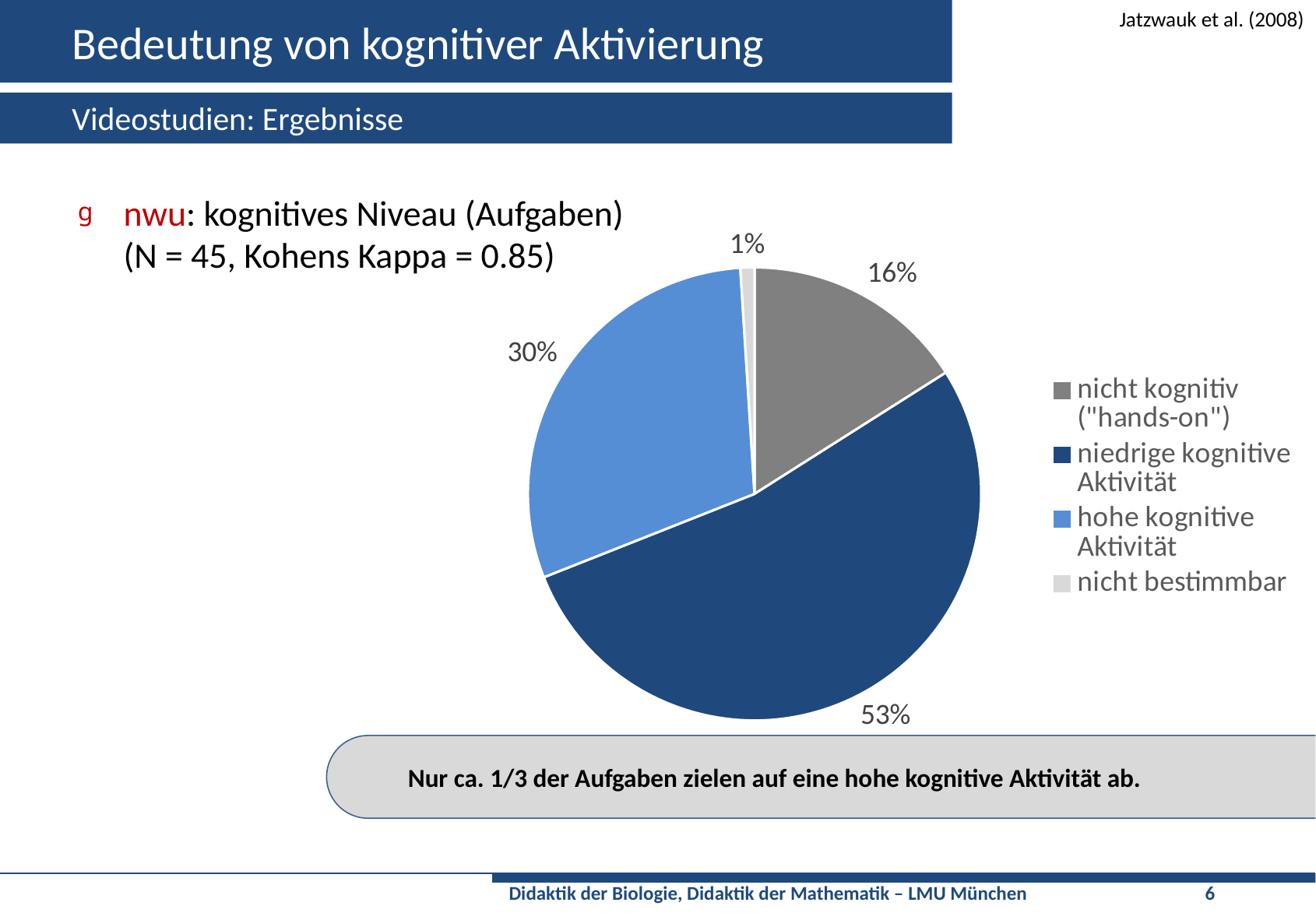
What kind of chart is shown on the slide? pie chart What colour is the slice for "hohe kognitive Aktivität"? light blue How many slices does the pie chart have? 4 Which is larger: the slice for "hohe kognitive Aktivität" or the slice for "nicht kognitiv ("hands-on")"? hohe kognitive Aktivität Which category has the largest slice of the pie? niedrige kognitive Aktivität What is the difference in percentage points between "niedrige kognitive Aktivität" and "hohe kognitive Aktivität"? 23 percentage points What share of the pie is labelled "nicht bestimmbar"? 1% How many entries does the legend list? 4 Which category has the smallest slice of the pie? nicht bestimmbar What share of the pie is labelled "niedrige kognitive Aktivität"? 53% What share of the pie is labelled "nicht kognitiv ("hands-on")"? 16% What share of the pie is labelled "hohe kognitive Aktivität"? 30%